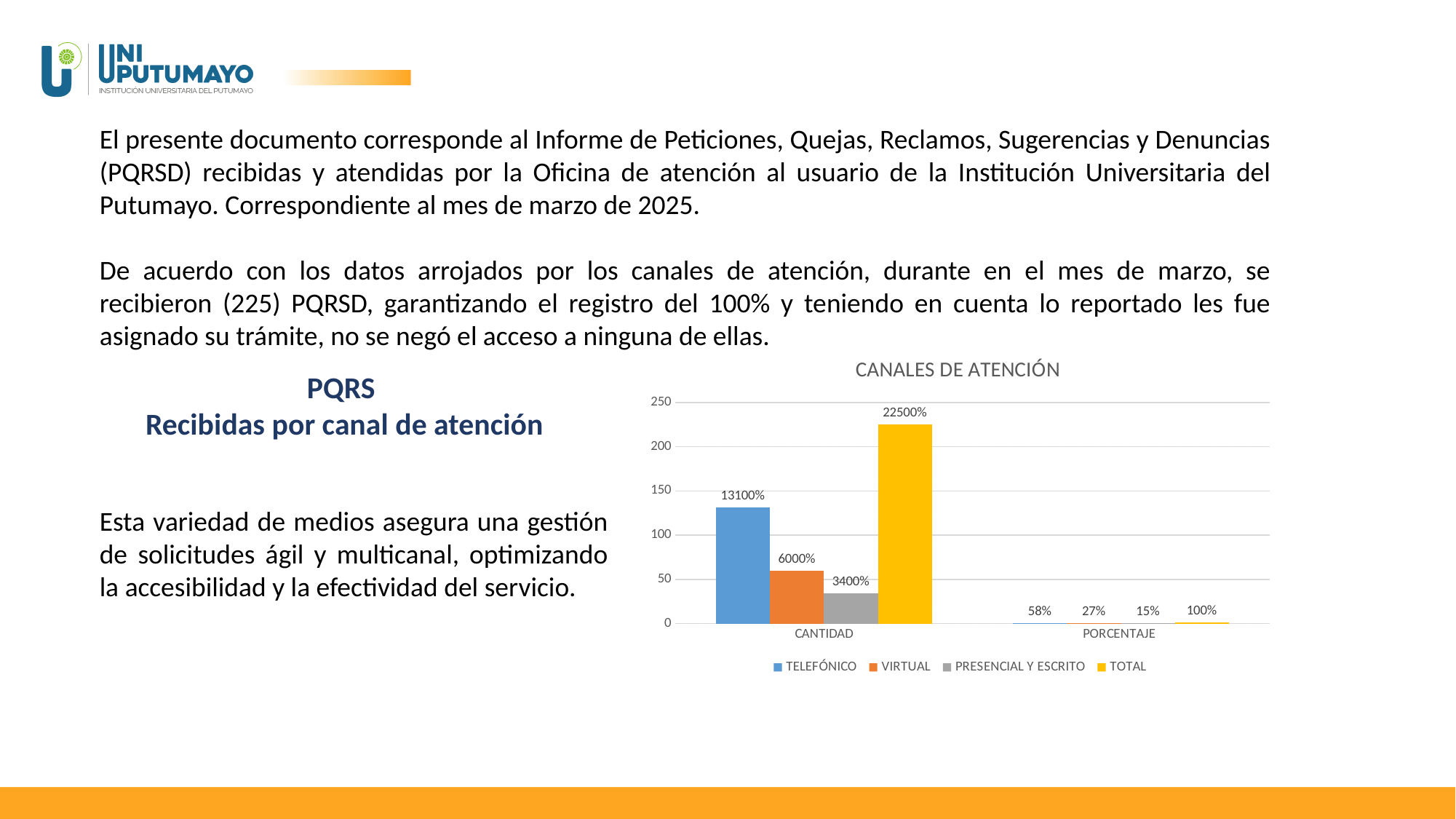
Which series has the lowest value in the CANTIDAD category? PRESENCIAL Y ESCRITO What is the data label for PRESENCIAL Y ESCRITO in the PORCENTAJE category? 15% How many categories are shown on the x axis of the chart? 2 What is the data label for TELEFÓNICO in the CANTIDAD category? 13100% Which is larger in the PORCENTAJE category, TELEFÓNICO or VIRTUAL? TELEFÓNICO What is the data label for TELEFÓNICO in the PORCENTAJE category? 58% What is the data label for PRESENCIAL Y ESCRITO in the CANTIDAD category? 3400% What kind of chart is shown on the slide? bar chart What is the data label for VIRTUAL in the CANTIDAD category? 6000% What is the title of the chart? CANALES DE ATENCIÓN What is the data label for TOTAL in the CANTIDAD category? 22500% How many series does the chart legend list? 4